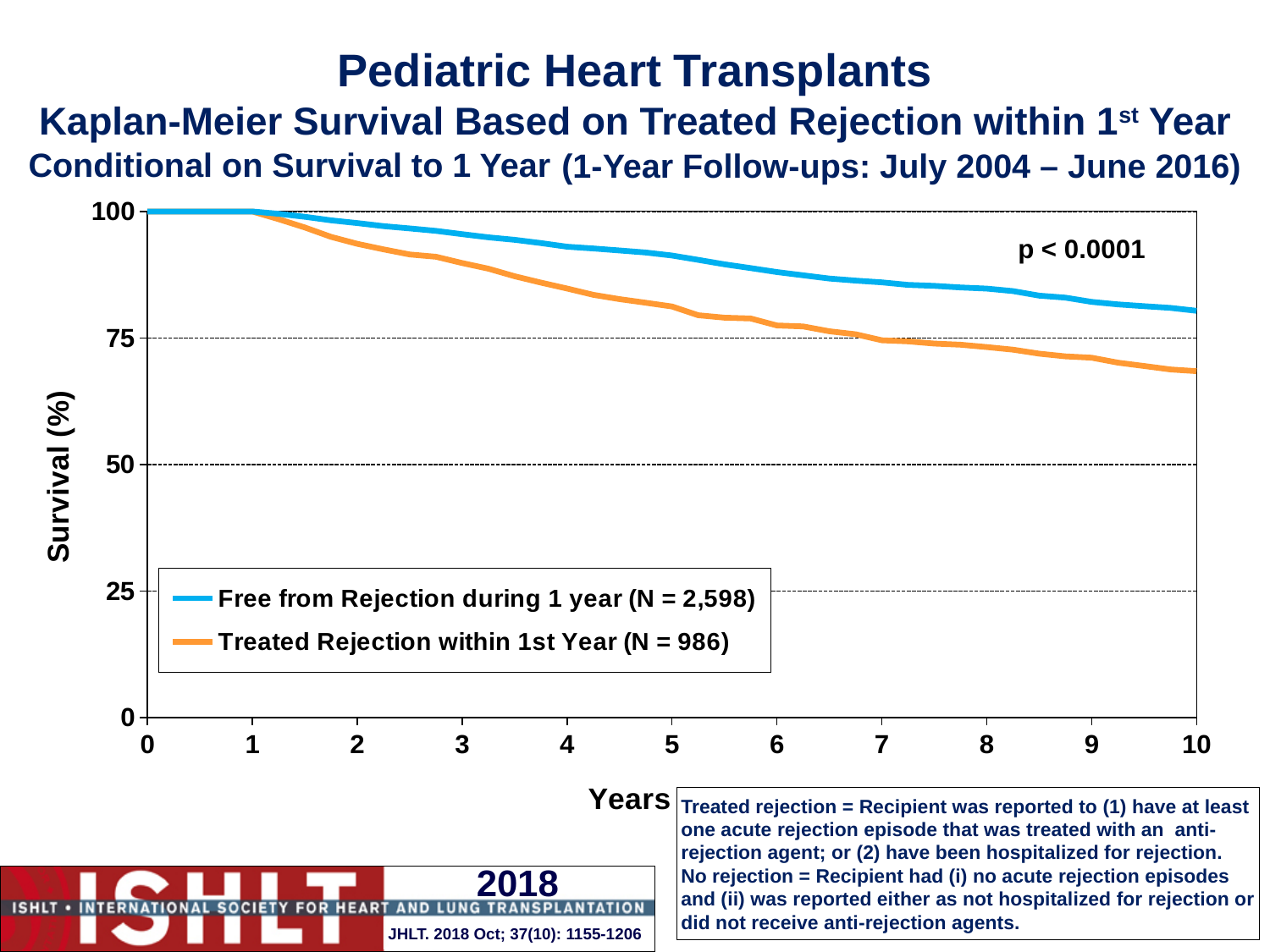
What kind of chart is shown on the slide? Line chart Do the survival curves rise or fall as the years increase? Fall What p-value is printed on the chart? p < 0.0001 Is the survival value for Treated Rejection within 1st Year at year 10 greater or less than 75? less Is the survival value for Treated Rejection within 1st Year at year 5 greater or less than 75? greater Which group has the lowest survival at year 10? Treated Rejection within 1st Year Is the survival value for Free from Rejection during 1 year at year 10 greater or less than 75? greater What is the survival value for both groups at year 0? 100 How many year tick marks are shown on the x axis? 11 How many series does the legend list? 2 What is the N for the Treated Rejection within 1st Year group shown in the legend? 986 At year 10, which group has the higher survival: Free from Rejection during 1 year or Treated Rejection within 1st Year? Free from Rejection during 1 year